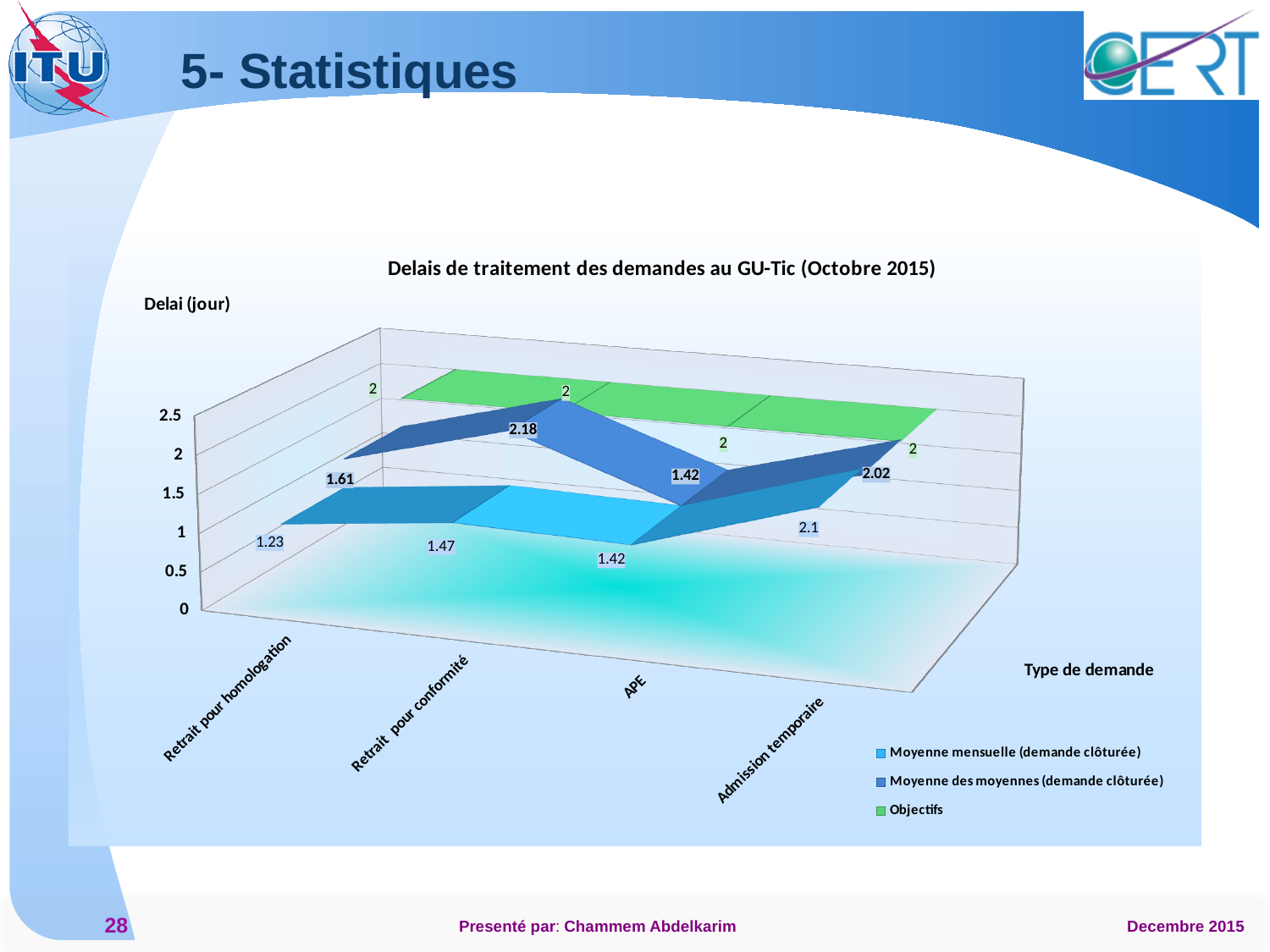
Which is larger for Admission temporaire: the Moyenne mensuelle (demande clôturée) value or the Objectifs value? Moyenne mensuelle (demande clôturée) What is the Moyenne mensuelle (demande clôturée) value for Admission temporaire? 2.1 How many types of demande (categories) are shown on the x axis? 4 What kind of chart is shown on the slide? 3D line chart What is the Moyenne mensuelle (demande clôturée) value for Retrait pour homologation? 1.23 What is the Moyenne des moyennes (demande clôturée) value for Retrait pour conformité? 2.18 Which type of demande has the lowest Moyenne des moyennes (demande clôturée) value? APE How many series does the legend list? 3 What is the title of the chart? Delais de traitement des demandes au GU-Tic (Octobre 2015) What is the Objectifs value for APE? 2 Which type of demande has the highest Moyenne mensuelle (demande clôturée) value? Admission temporaire What is the difference between the Moyenne des moyennes and the Moyenne mensuelle values for Retrait pour conformité? 0.71